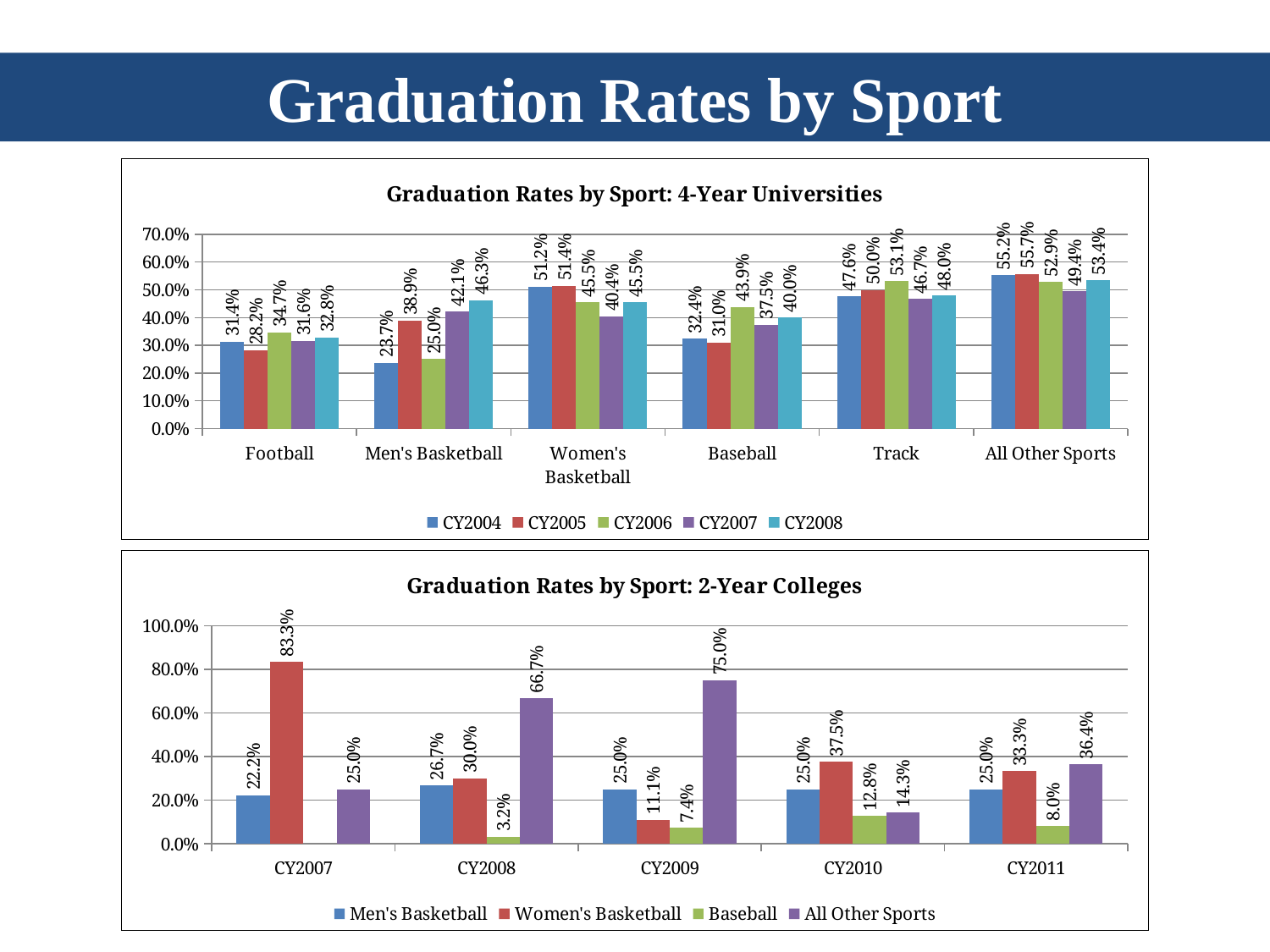
In the 'Graduation Rates by Sport: 4-Year Universities' chart, which sport has the lowest CY2004 graduation rate? Men's Basketball In the 'Graduation Rates by Sport: 4-Year Universities' chart, how many series does the legend list? 5 In the 'Graduation Rates by Sport: 2-Year Colleges' chart, what is the Baseball graduation rate for CY2008? 3.2% In the 'Graduation Rates by Sport: 2-Year Colleges' chart, what is the Women's Basketball graduation rate for CY2007? 83.3% In the 'Graduation Rates by Sport: 4-Year Universities' chart, what is the CY2006 graduation rate for Baseball? 43.9% What type of chart is the 'Graduation Rates by Sport: 2-Year Colleges' chart? Bar chart In the 'Graduation Rates by Sport: 4-Year Universities' chart, what is the difference between the CY2008 and CY2004 graduation rates for Men's Basketball? 22.6% In the 'Graduation Rates by Sport: 4-Year Universities' chart, what is the CY2008 graduation rate for Men's Basketball? 46.3% In the 'Graduation Rates by Sport: 4-Year Universities' chart, how many sport categories are shown on the x axis? 6 In the 'Graduation Rates by Sport: 2-Year Colleges' chart, is the Women's Basketball rate for CY2010 larger or smaller than the All Other Sports rate for CY2010? larger In the 'Graduation Rates by Sport: 2-Year Colleges' chart, which year has the highest All Other Sports graduation rate? CY2009 In the 'Graduation Rates by Sport: 4-Year Universities' chart, which sport has the highest CY2005 graduation rate? All Other Sports